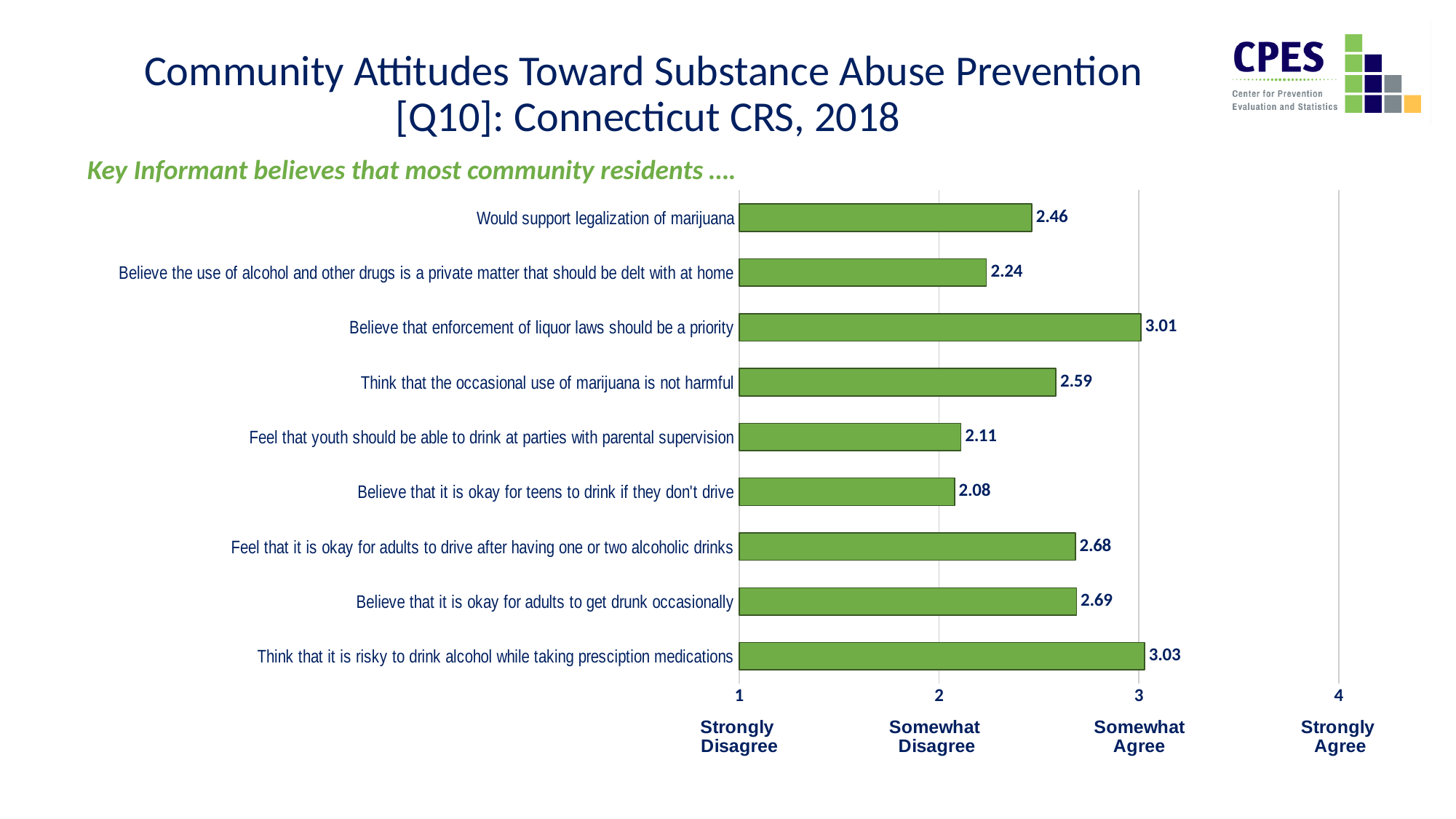
Which category has the highest value? Think that it is risky to drink alcohol while taking presciption medications What response label is shown at the value 4 on the x axis? Strongly Agree Is the value for "Feel that it is okay for adults to drive after having one or two alcoholic drinks" greater or less than 3? less Which category has the lowest value? Believe that it is okay for teens to drink if they don't drive What is the value for "Believe that enforcement of liquor laws should be a priority"? 3.01 How many categories are shown in the chart? 9 What is the value for "Feel that youth should be able to drink at parties with parental supervision"? 2.11 What is the value for "Would support legalization of marijuana"? 2.46 Which is larger: the value for "Think that the occasional use of marijuana is not harmful" or the value for "Believe that it is okay for teens to drink if they don't drive"? Think that the occasional use of marijuana is not harmful What is the difference between the highest value (3.03) and the lowest value (2.08)? 0.95 What is the difference between "Would support legalization of marijuana" and "Believe the use of alcohol and other drugs is a private matter that should be delt with at home"? 0.22 What kind of chart is shown on the slide? bar chart